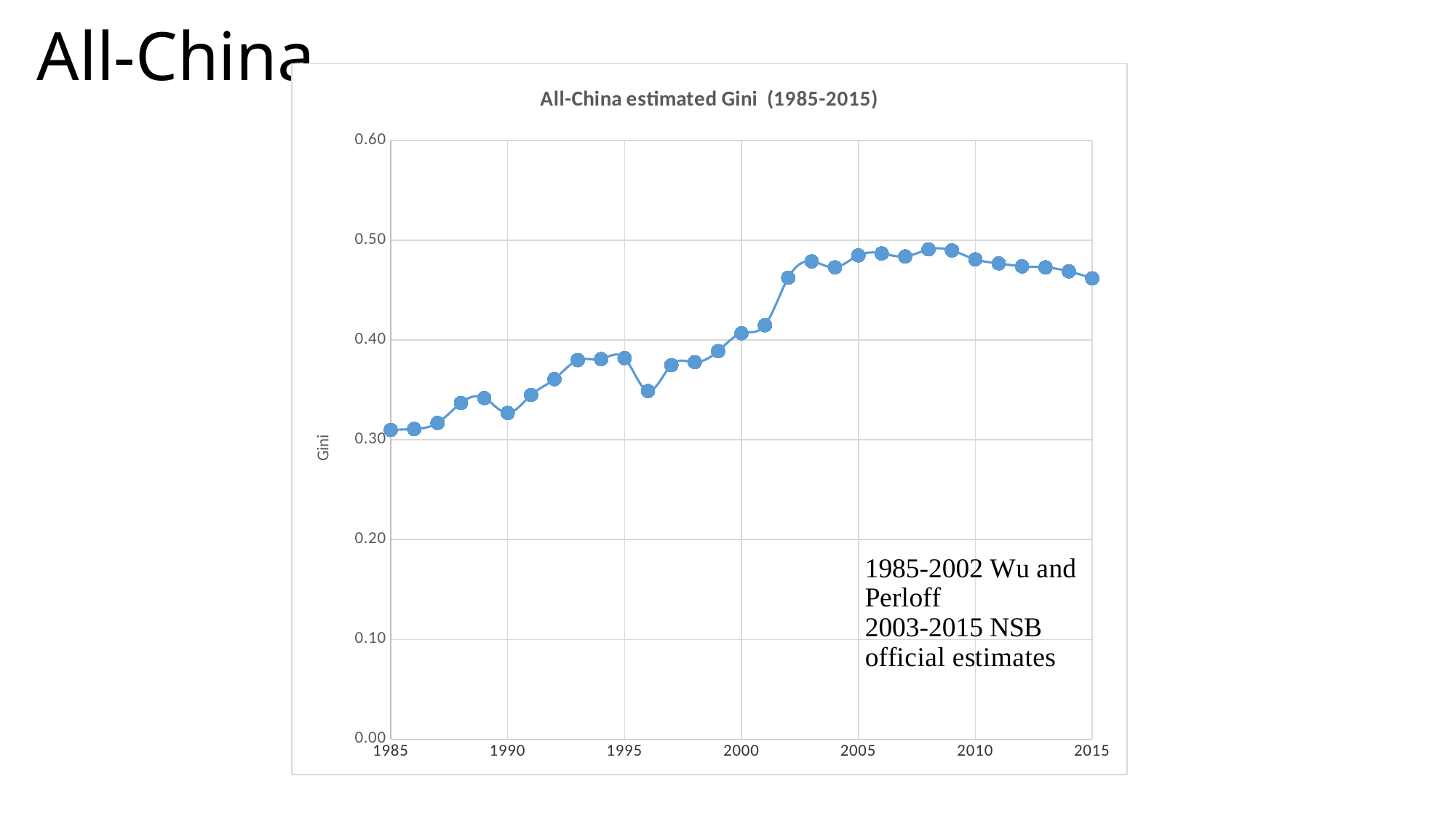
Is the value for 2005 greater or less than 0.50? less What is the label on the vertical axis of the chart? Gini Is the value for 2015 greater or less than 0.40? greater Is the value for 1985 greater or less than 0.30? greater Which year has the larger value, 1985 or 2015? 2015 Which year has the larger value, 1995 or 1996? 1995 Do the values generally rise or fall from 1985 to 2008? rise What is the title of the chart? All-China estimated Gini (1985-2015) What kind of chart is shown on the slide? line chart How many data points are plotted on the chart? 31